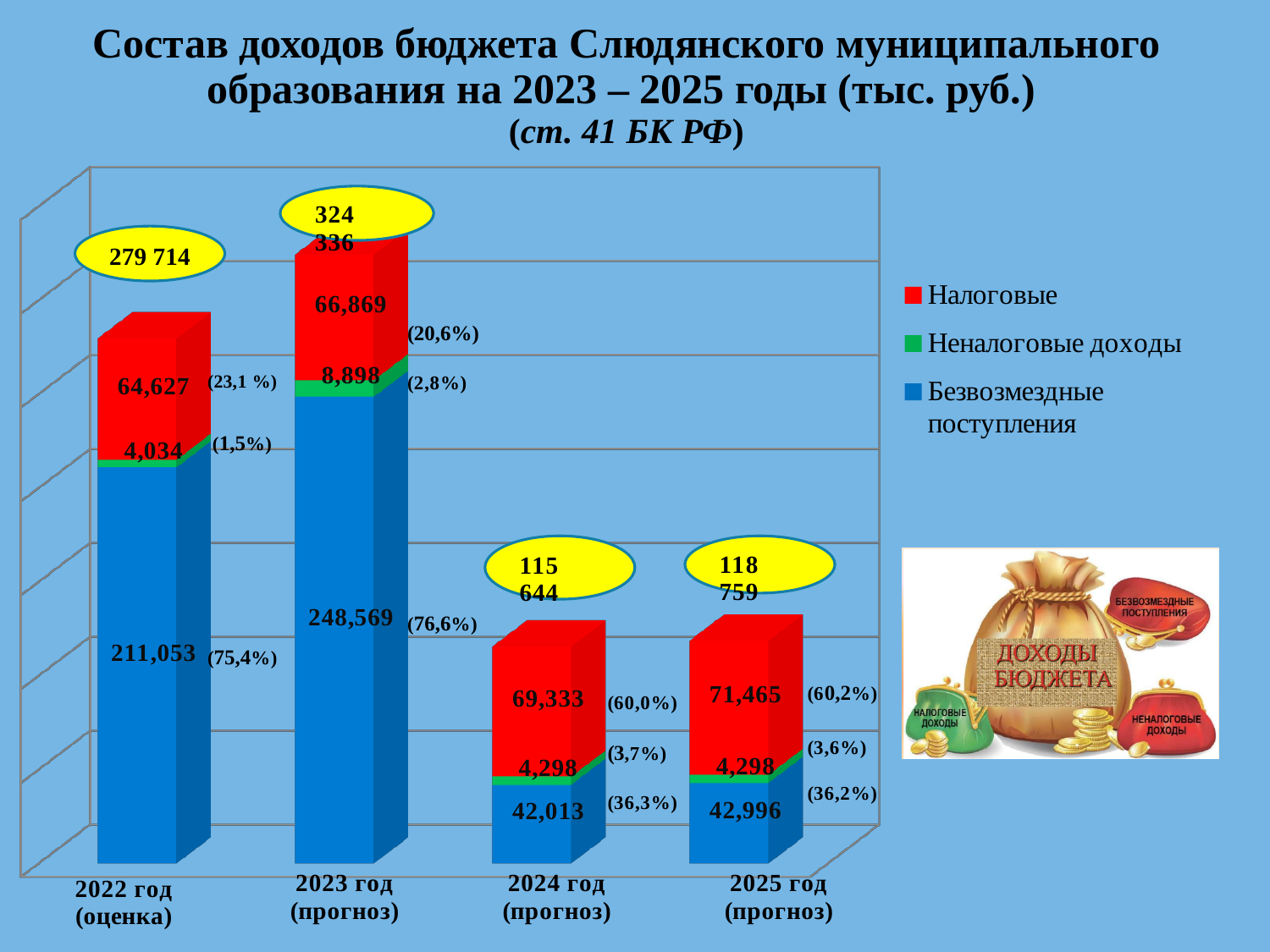
Which year has the highest total budget income? 2023 год (прогноз) What is the value of Налоговые for 2022 год (оценка)? 64,627 Which year has the lowest total budget income? 2024 год (прогноз) How many year categories are shown on the x axis? 4 How many series does the legend list? 3 Which is larger: Безвозмездные поступления in 2022 год (оценка) or in 2025 год (прогноз)? 2022 год (оценка) What is the total shown above the bar for 2025 год (прогноз)? 118 759 What is the value of Неналоговые доходы for 2024 год (прогноз)? 4,298 What percentage share is shown for Безвозмездные поступления in 2023 год (прогноз)? (76,6%) What is the value of Безвозмездные поступления for 2023 год (прогноз)? 248,569 What is the difference between Налоговые in 2025 год (прогноз) and 2024 год (прогноз)? 2,132 What kind of chart is shown on the slide? Stacked bar chart